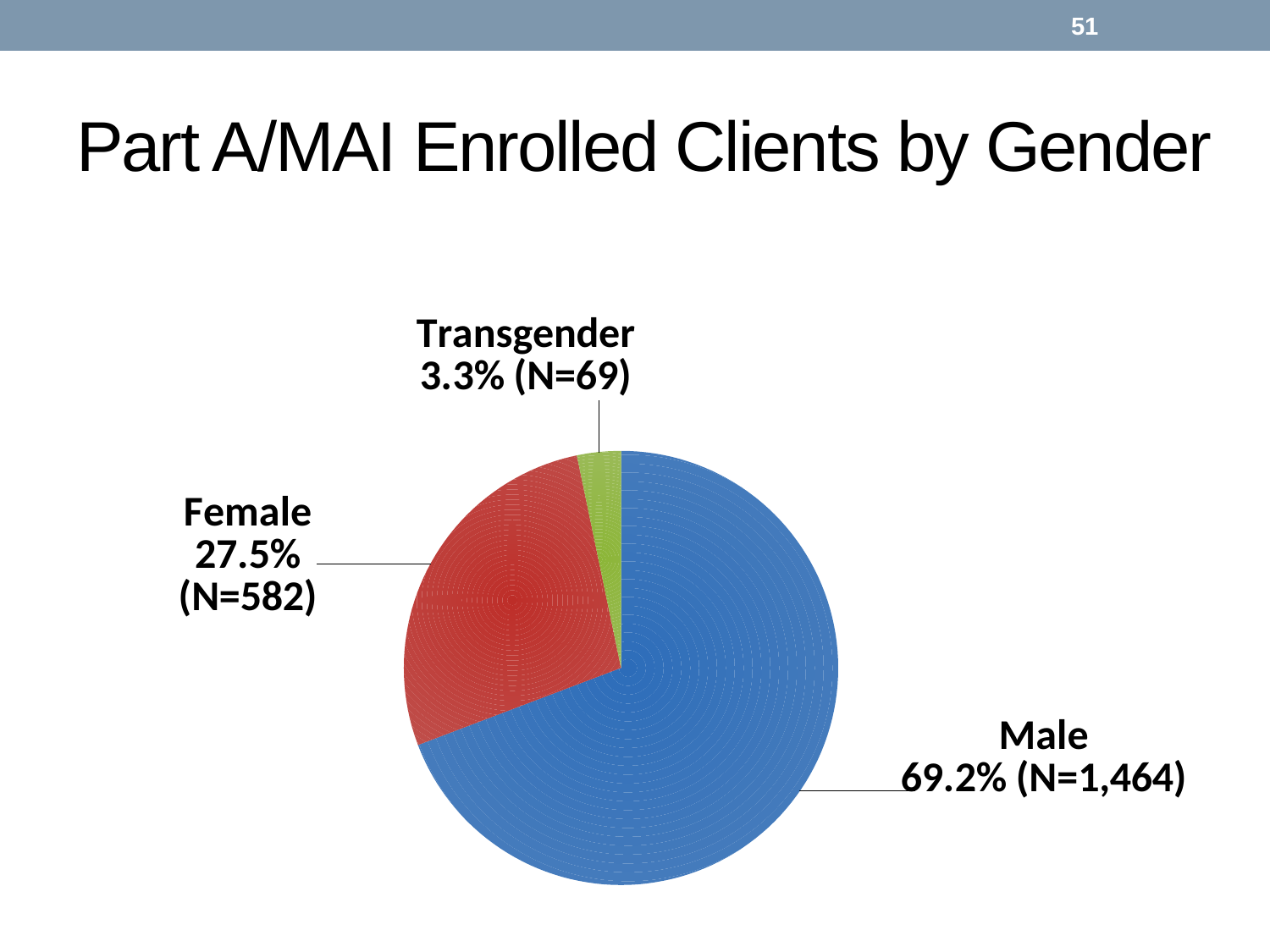
What percentage of Part A/MAI enrolled clients are Female? 27.5% How many gender categories are shown in the pie chart? 3 How many Male clients are shown in the pie chart? 1,464 What type of chart is shown on the slide? Pie chart How many Transgender clients are shown in the pie chart? 69 Which is larger, the Female share or the Transgender share? Female What is the difference in percentage points between the Male and Female shares? 41.7 Which gender category has the smallest share of enrolled clients? Transgender What percentage of Part A/MAI enrolled clients are Male? 69.2% What percentage of Part A/MAI enrolled clients are Transgender? 3.3% How many Female clients are shown in the pie chart? 582 Which gender category has the largest share of enrolled clients? Male